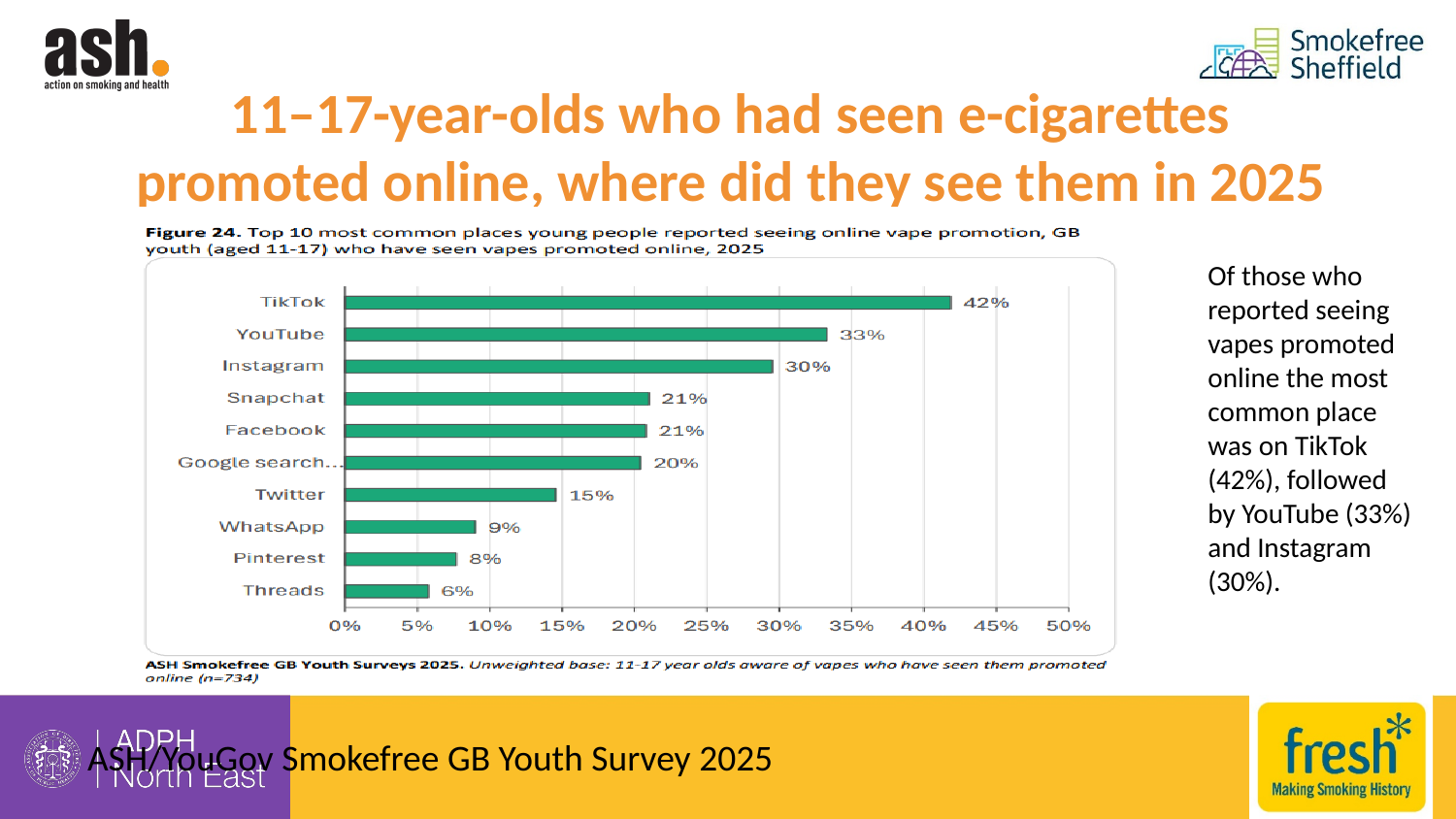
What is the value shown for Instagram? 30% How many places are listed in the chart? 10 What is the difference between the values for TikTok and YouTube? 9% What is the highest value shown on the x axis of the chart? 50% Is the value for Google search greater or less than 25%? less Which has a larger value, Instagram or Snapchat? Instagram What kind of chart is shown on the slide? Bar chart Which place has the lowest percentage in the chart? Threads Which place has the highest percentage in the chart? TikTok What is the difference between the values for WhatsApp and Pinterest? 1% What percentage is shown for Twitter? 15% What percentage of young people reported seeing vape promotion on TikTok? 42%